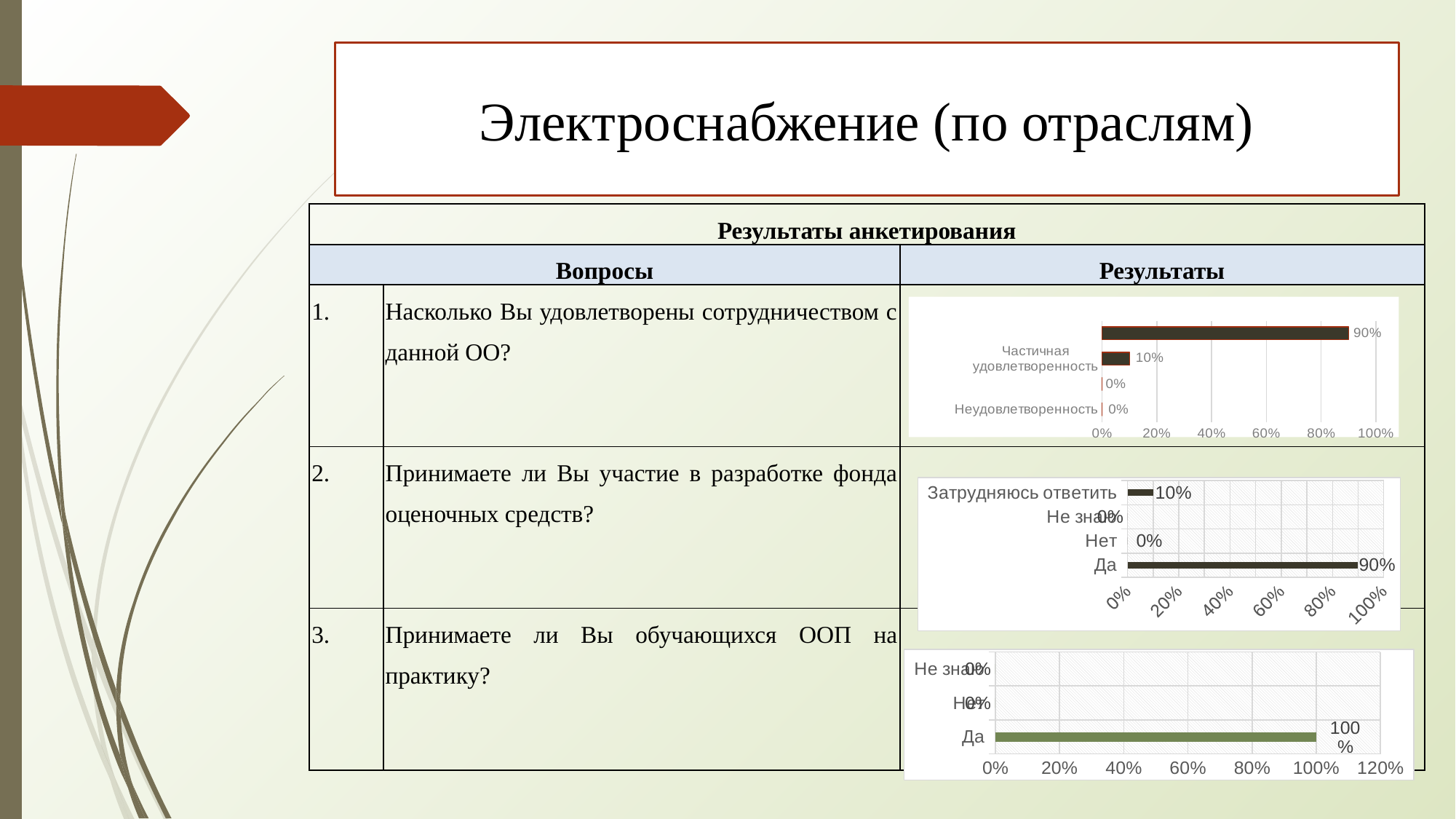
How many categories are shown in the bottom chart (question 3)? 3 In the bottom chart (question 3), which category has the highest value? Да In the middle chart (question 2), what is the value for "Затрудняюсь ответить"? 10% In the top chart (question 1), what is the value for "Частичная удовлетворенность"? 10% In the bottom chart (question 3), what is the value for "Да"? 100% In the top chart (question 1), what is the value for "Неудовлетворенность"? 0% In the middle chart (question 2), what is the value for "Нет"? 0% In the middle chart (question 2), which category has the highest value? Да What kind of chart is the bottom chart (question 3)? Bar chart In the middle chart (question 2), what is the value for "Да"? 90% In the middle chart (question 2), what is the difference between the values for "Да" and "Затрудняюсь ответить"? 80% In the middle chart (question 2), which is larger: the value for "Да" or the value for "Затрудняюсь ответить"? Да